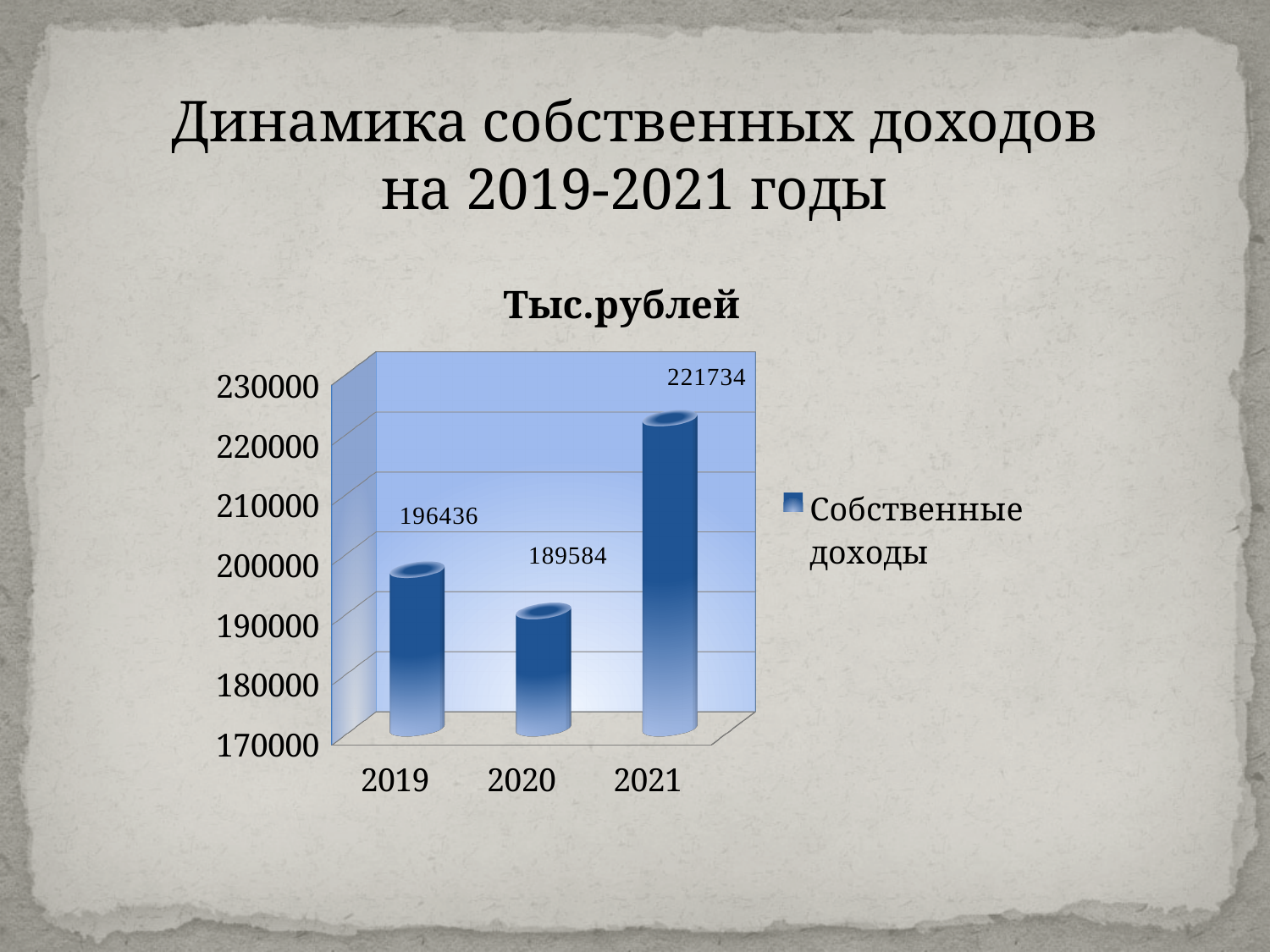
What is the value for 2020? 189584 What kind of chart is shown on the slide? bar chart Is the value for 2021 greater or less than 220000? greater What is the title of the chart? Тыс.рублей How many years are shown on the x axis? 3 What is the value for 2021? 221734 What is the value for 2019? 196436 Which is larger, the value for 2019 or the value for 2020? 2019 What is the difference between the values for 2021 and 2019? 25298 Which year has the highest value? 2021 Which year has the lowest value? 2020 What is the difference between the values for 2019 and 2020? 6852